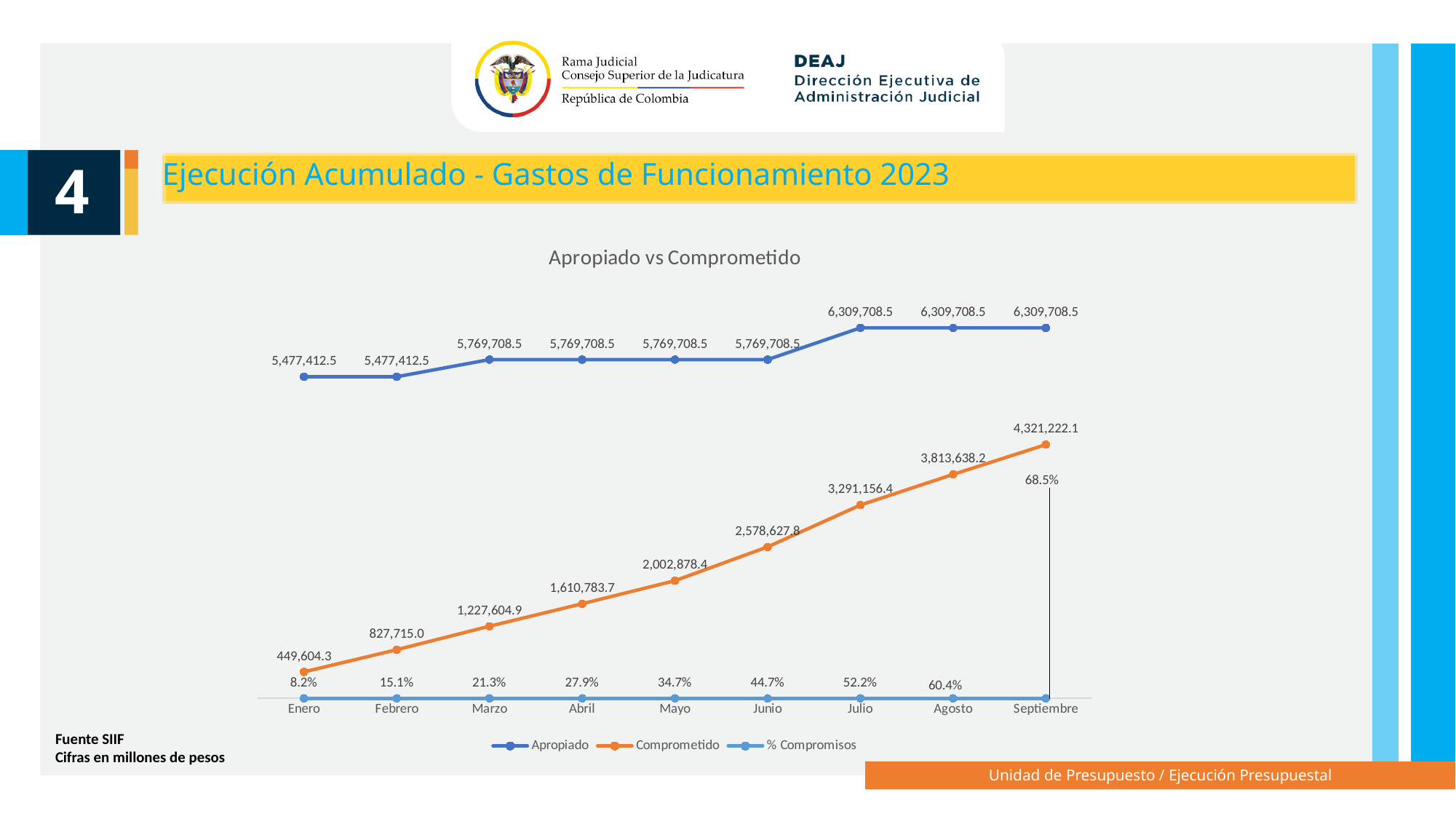
What is the Comprometido value for Septiembre? 4,321,222.1 What is the Apropiado value for Enero? 5,477,412.5 How many months are shown on the x axis? 9 What is the Comprometido value for Abril? 1,610,783.7 In which month is the Comprometido value lowest? Enero Does the Comprometido series rise or fall from Enero to Septiembre? Rise Which is larger, the Comprometido value for Marzo or the Comprometido value for Febrero? Marzo What is the % Compromisos value for Mayo? 34.7% How many series does the legend list? 3 What kind of chart is shown? Line chart In which month is the % Compromisos value highest? Septiembre What is the difference between the Apropiado value in Julio and the Apropiado value in Junio? 540,000.0